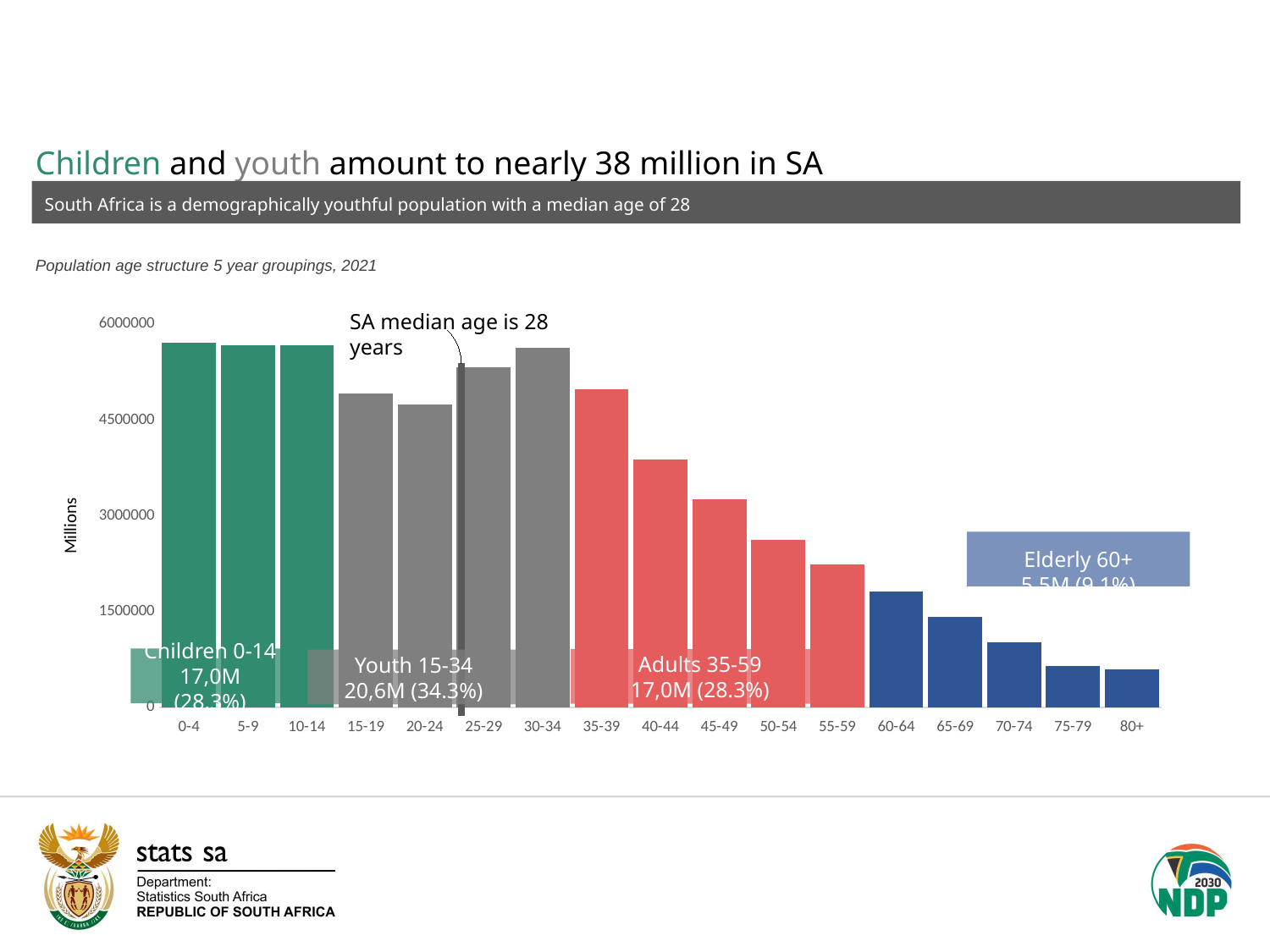
Is the value for the 40-44 age group greater or less than 4500000? less Is the value for the 0-4 age group greater or less than 4500000? greater Is the value for the 80+ age group greater or less than 1500000? less According to the chart annotation, what is the total population of Youth 15-34? 20,6M (34.3%) Which age group has the larger value, 55-59 or 60-64? 55-59 What is the median age of South Africa stated on the chart? 28 years According to the chart annotation, what percentage of the population is Elderly 60+? 9.1% What kind of chart is shown on the slide? Bar chart Do the values rise or fall along the x axis from the 35-39 group to the 80+ group? fall How many age-group categories are shown on the x axis? 17 Which age group has the larger value, 15-19 or 40-44? 15-19